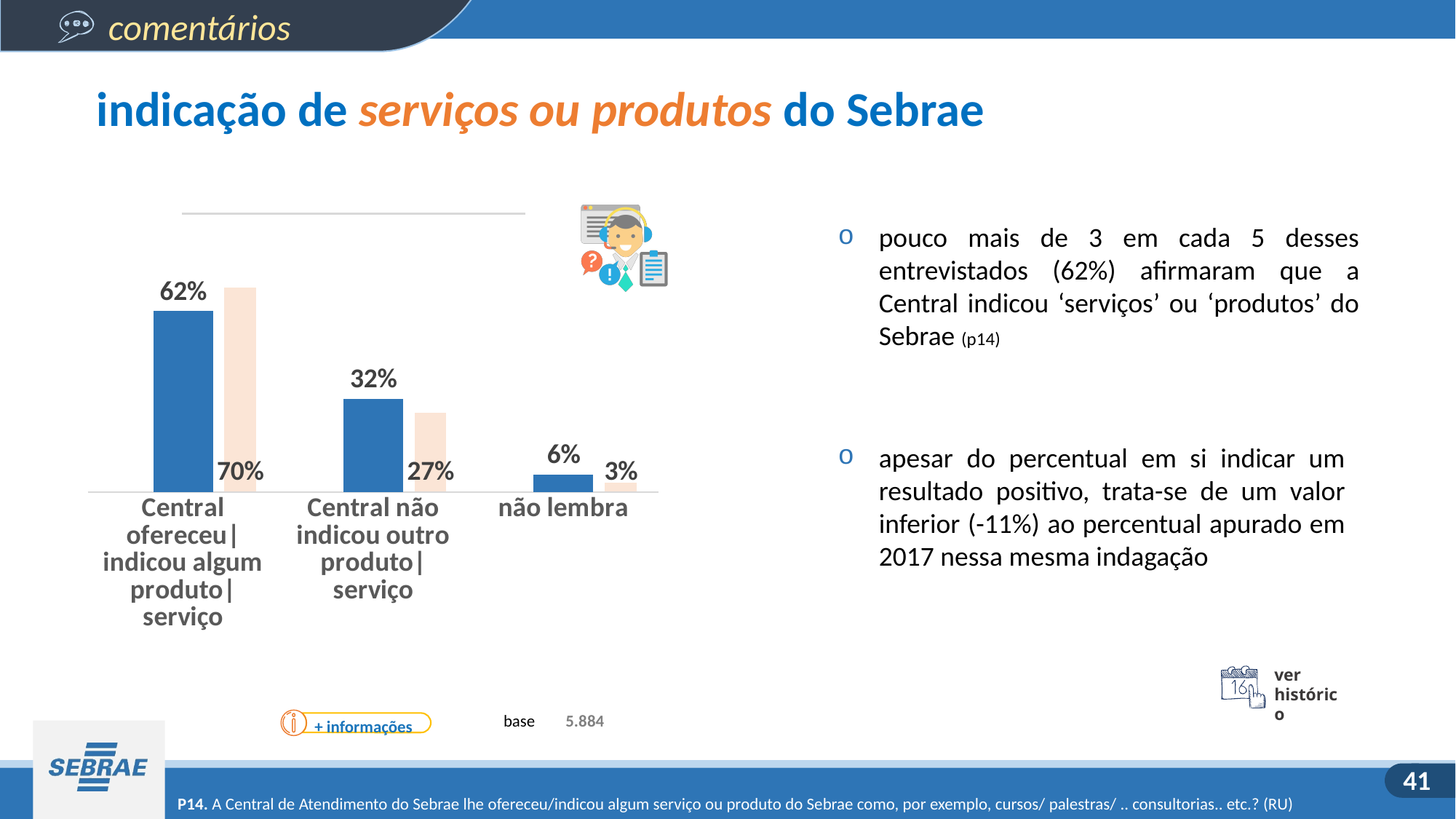
What kind of chart is shown on the slide? bar chart What is the value of the light orange bar for 'não lembra'? 3% What is the value of the blue bar for 'Central ofereceu|indicou algum produto|serviço'? 62% How many categories are shown on the x axis of the chart? 3 For 'não lembra', which bar is larger, the blue one or the light orange one? the blue one What is the value of the blue bar for 'Central não indicou outro produto|serviço'? 32% What is the base (number of respondents) shown below the chart? 5.884 What is the value of the light orange bar for 'Central ofereceu|indicou algum produto|serviço'? 70% Which category has the lowest light orange bar? não lembra Which category has the highest blue bar? Central ofereceu|indicou algum produto|serviço What is the difference between the light orange bar and the blue bar for 'Central ofereceu|indicou algum produto|serviço'? 8% What is the difference between the blue bar and the light orange bar for 'Central não indicou outro produto|serviço'? 5%